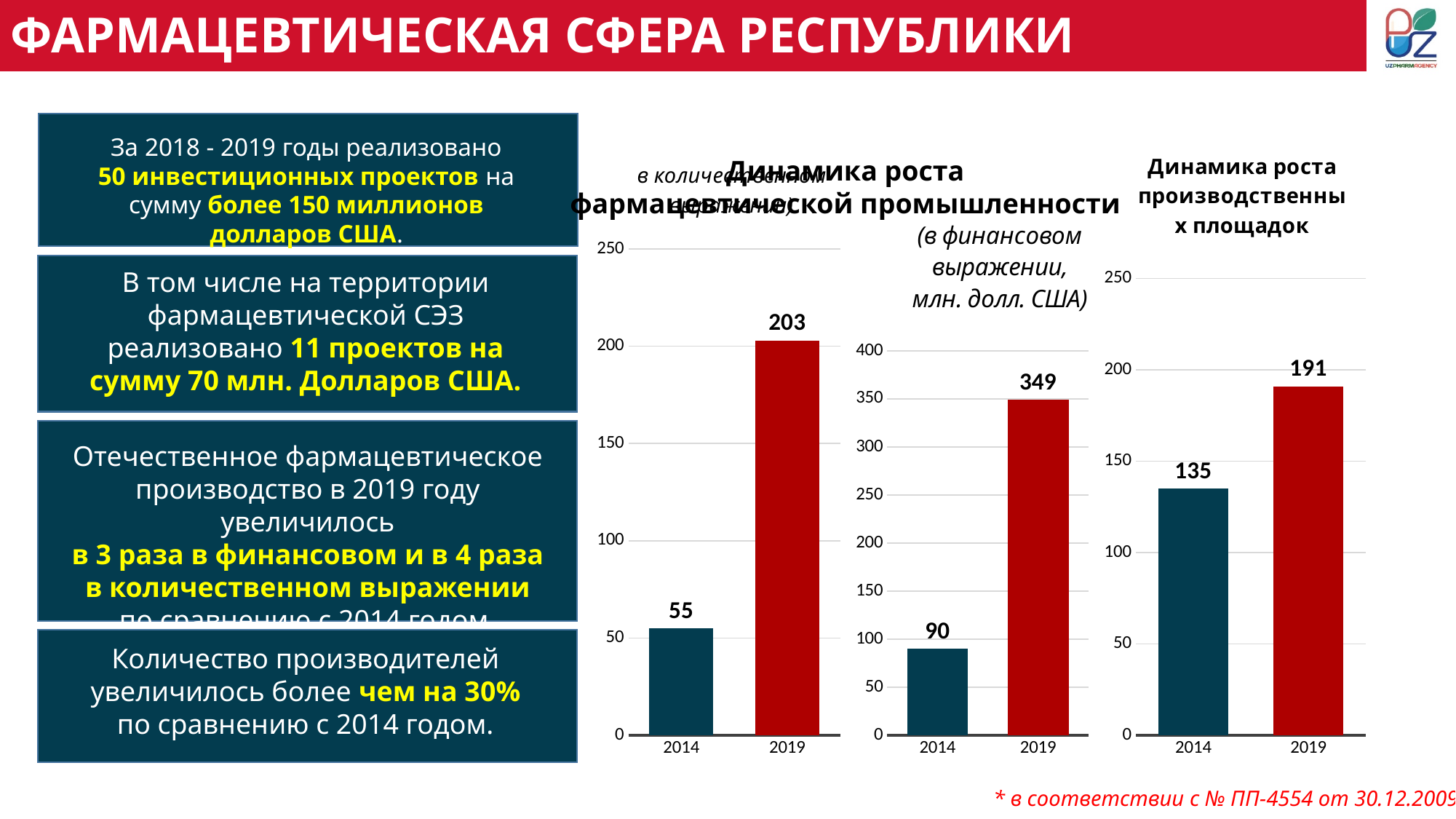
How many categories are shown on the x axis of the middle chart? 2 In the right chart (Динамика роста производственных площадок), what is the value for 2014? 135 In the middle chart (в финансовом выражении, млн. долл. США), what is the difference between the 2019 and 2014 values? 259 In the right chart (Динамика роста производственных площадок), what is the value for 2019? 191 In the middle chart (в финансовом выражении, млн. долл. США), what is the value for 2014? 90 In the middle chart (в финансовом выражении, млн. долл. США), what is the value for 2019? 349 In the left chart, what is the value for 2014? 55 What type of chart is the right chart (Динамика роста производственных площадок)? Bar chart In the right chart (Динамика роста производственных площадок), which year has the higher value? 2019 In the left chart, what is the difference between the 2019 and 2014 values? 148 In the right chart (Динамика роста производственных площадок), what is the difference between the 2019 and 2014 values? 56 In the left chart, what is the value for 2019? 203